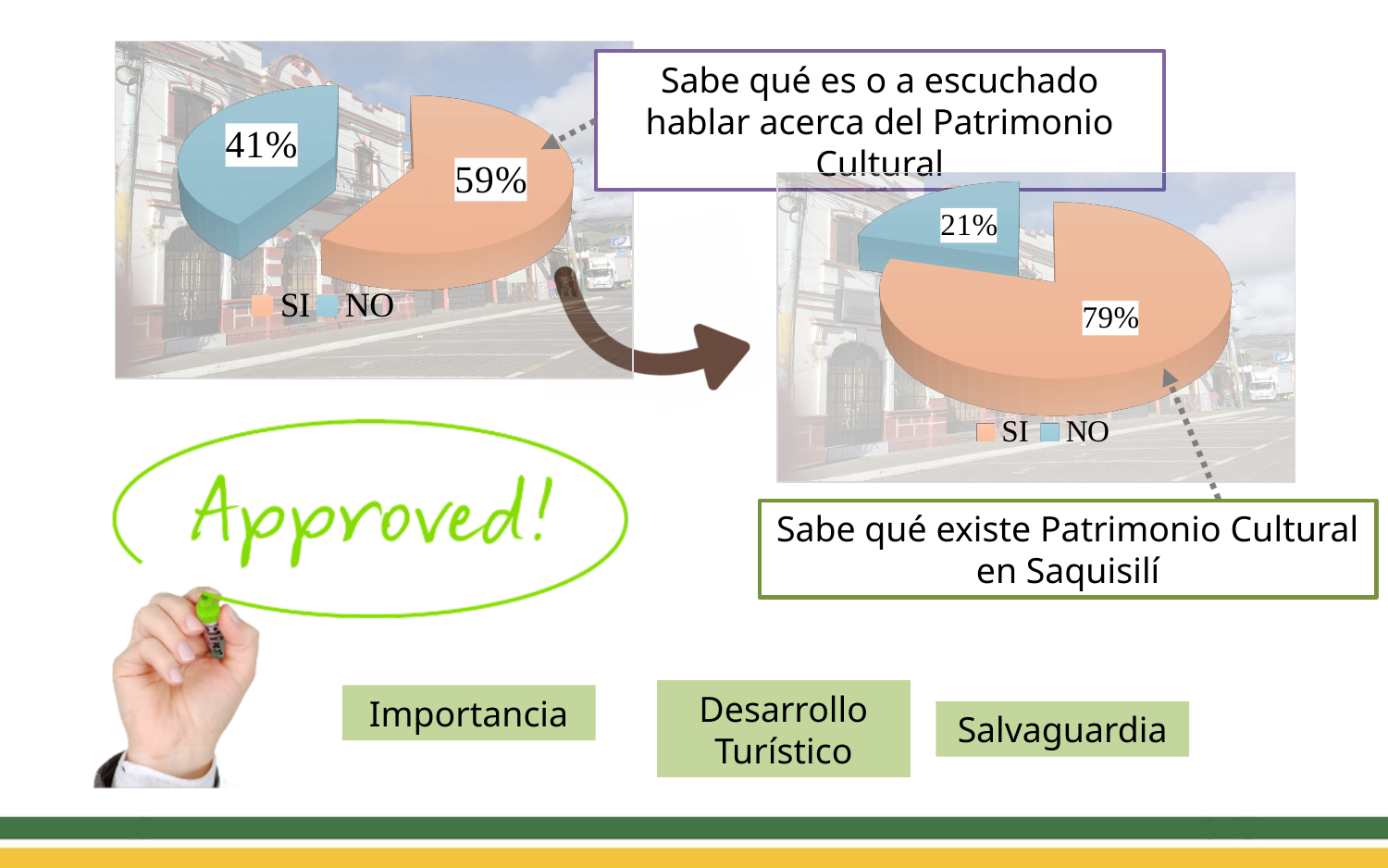
Which colour represents NO in the pie chart on the right? Blue What type of chart is the top-left chart? Pie chart How many categories does the legend of the pie chart on the right list? 2 In the top-left pie chart, what is the value for SI? 59% In the pie chart on the right, what is the value for NO? 21% In the top-left pie chart, which category has the largest share? SI In the top-left pie chart, what is the value for NO? 41% In the top-left pie chart, what is the difference between the SI and NO values? 18% Which is larger: the SI value in the top-left pie chart or the SI value in the pie chart on the right? The SI value in the pie chart on the right In the pie chart on the right, which category has the smallest share? NO In the pie chart on the right, what is the value for SI? 79% In the pie chart on the right, what is the difference between the SI and NO values? 58%